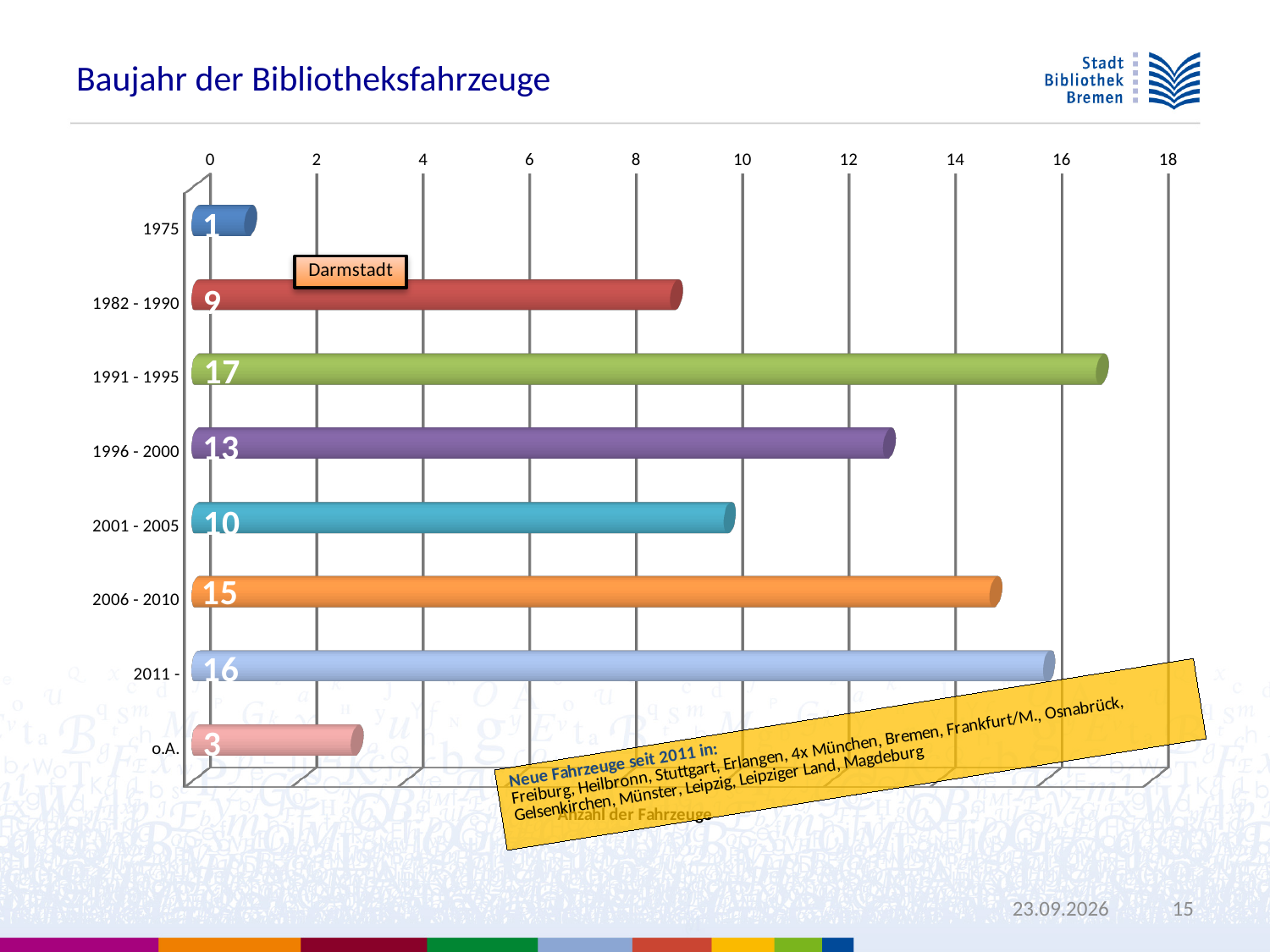
What kind of chart is shown on the slide? bar chart What is the value for o.A.? 3 What is the difference between the values for 2011 - and 2001 - 2005? 6 How many categories are shown on the chart? 8 Which category has the highest value? 1991 - 1995 What label is shown in the box next to the 1982 - 1990 bar? Darmstadt Is the value for 2006 - 2010 greater or less than 14? greater What is the value for 2006 - 2010? 15 Which is larger, the value for 1996 - 2000 or the value for 1982 - 1990? 1996 - 2000 What is the value for 1991 - 1995? 17 What is the title of the chart? Baujahr der Bibliotheksfahrzeuge Which category has the lowest value? 1975